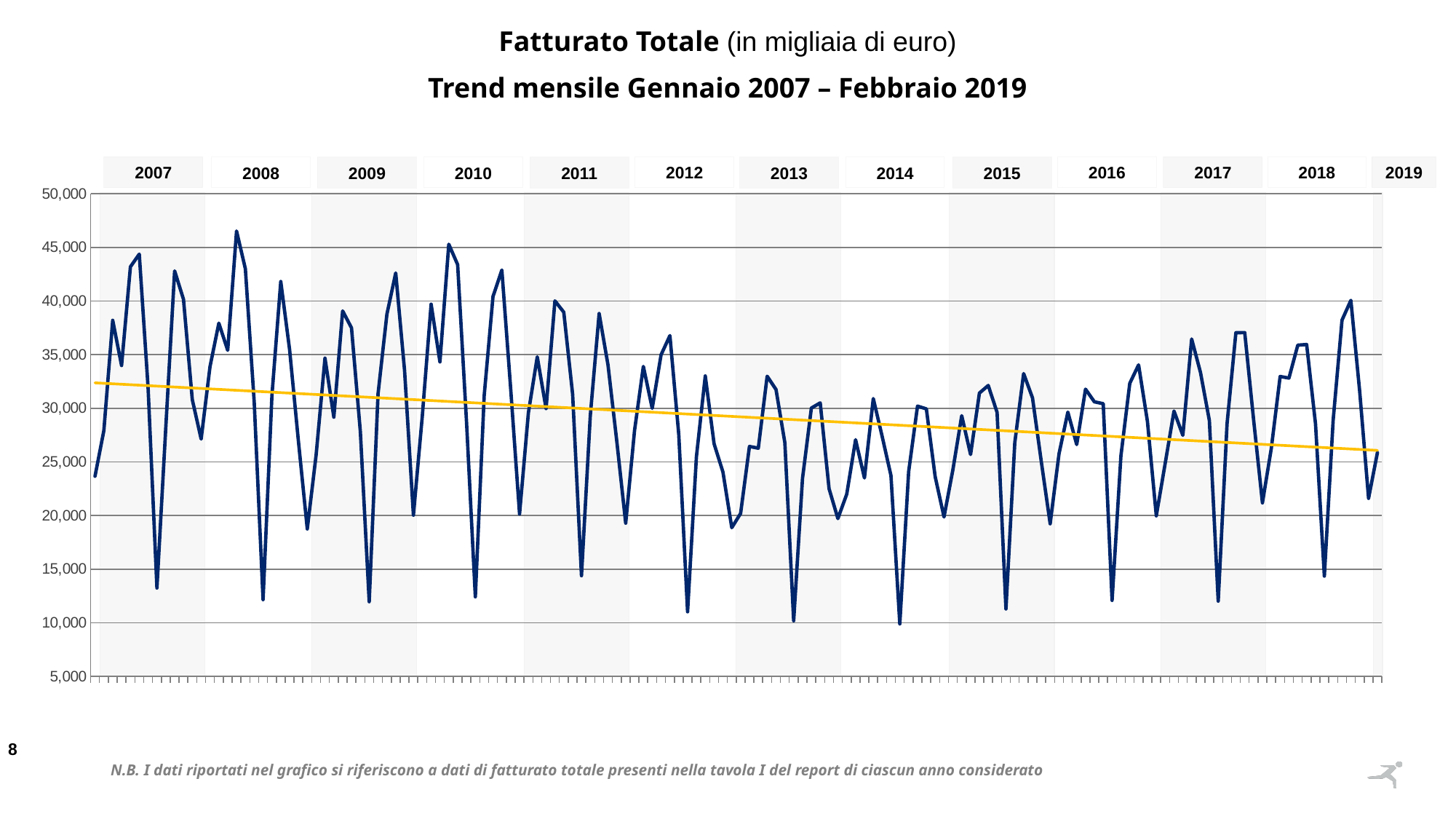
What is the highest value shown on the vertical axis? 50,000 In which year does the monthly revenue line reach its highest peak? 2008 Is the lowest point in 2007 greater or less than 15,000? less In what unit are the values in the chart expressed, according to the title? migliaia di euro What kind of chart is shown on the slide? line chart Is the highest peak in 2015 greater or less than 35,000? less Is the lowest point in 2008 greater or less than 10,000? greater How many year labels are shown along the top of the chart? 13 Does the yellow trend line rise or fall from 2007 to 2019? fall Is the highest peak in 2008 larger than the highest peak in 2016? yes